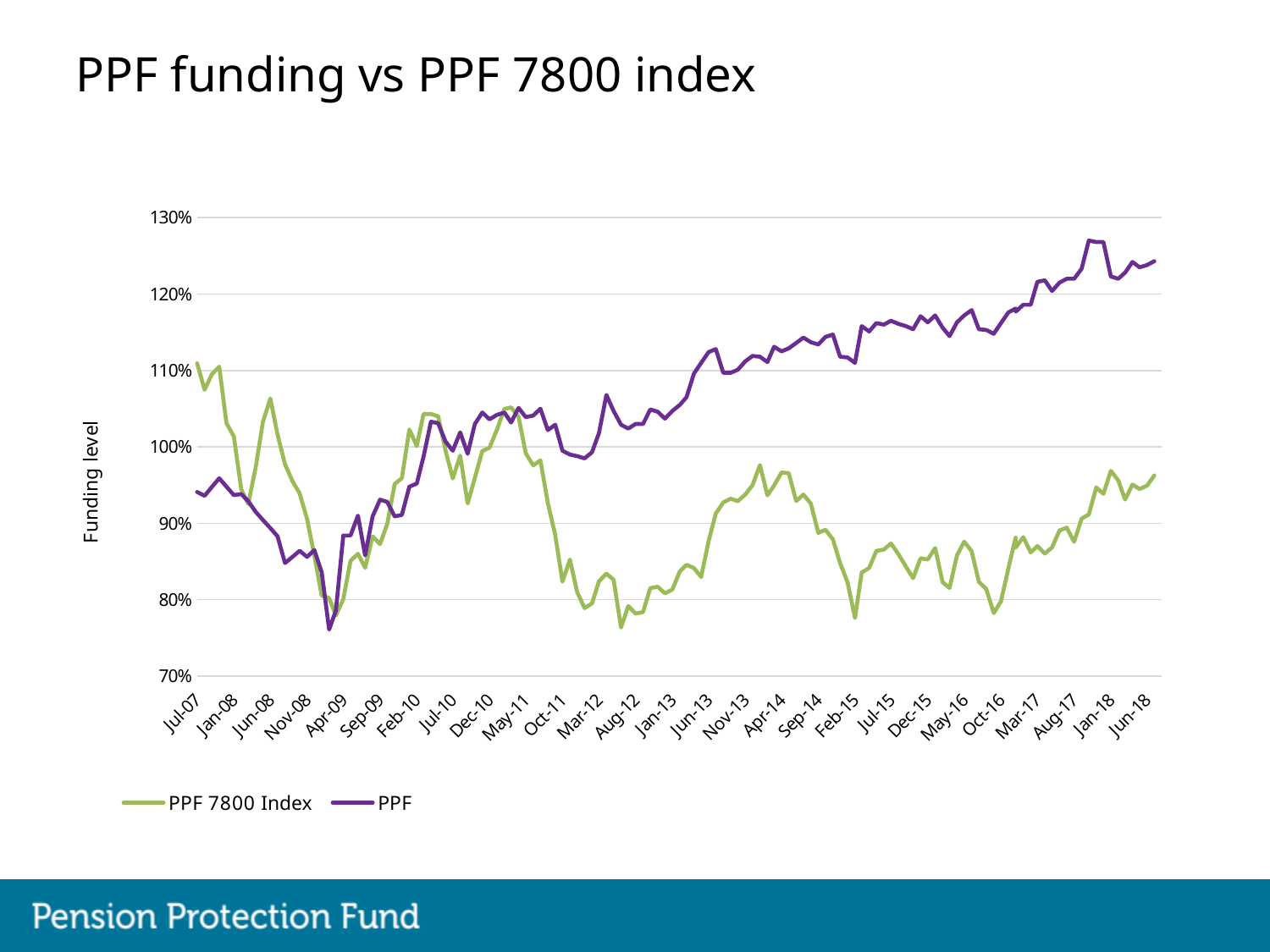
How many series does the legend list? 2 Is the value for PPF at Jul-07 greater or less than 100%? less Which series has the higher value at Jul-07, PPF 7800 Index or PPF? PPF 7800 Index What is the label on the vertical axis? Funding level Which series has the higher value at Jun-18, PPF 7800 Index or PPF? PPF Is the value for PPF 7800 Index at Jun-18 greater or less than 100%? less What is the title of the chart? PPF funding vs PPF 7800 index Is the value for PPF at Apr-09 greater or less than 80%? greater What kind of chart is shown on the slide? Line chart Does the PPF series overall rise or fall from Jul-07 to Jun-18? rise